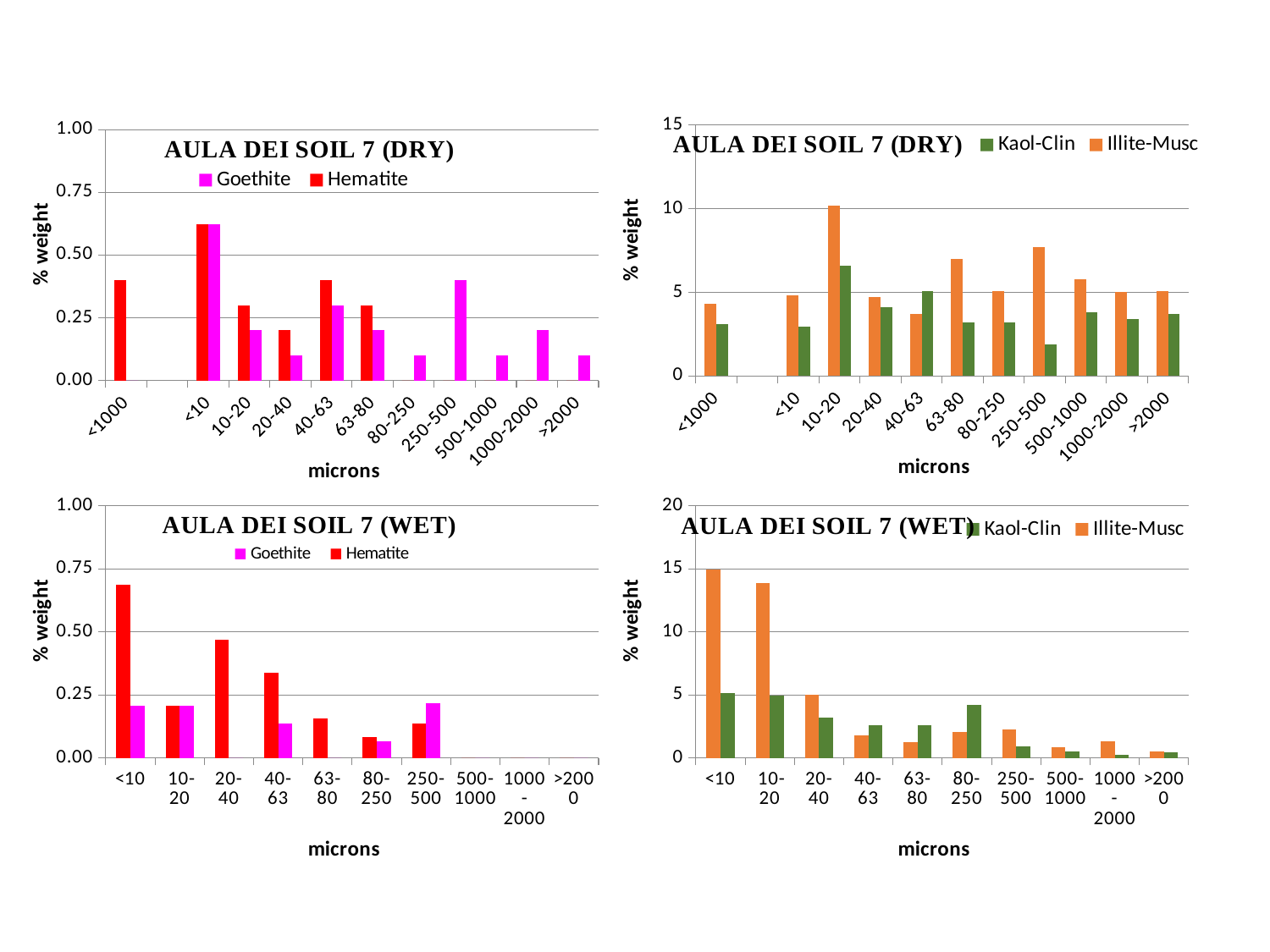
In the bottom-left chart (AULA DEI SOIL 7 (WET), Goethite/Hematite), is the Hematite value for 20-40 greater or less than 0.25? greater In the bottom-right chart (AULA DEI SOIL 7 (WET), Kaol-Clin/Illite-Musc), which is larger for the <10 category, Kaol-Clin or Illite-Musc? Illite-Musc In the top-left chart (AULA DEI SOIL 7 (DRY), Goethite/Hematite), is the Hematite value for <1000 greater or less than 0.25? greater In the top-left chart (AULA DEI SOIL 7 (DRY), Goethite/Hematite), how many micron categories are shown on the x axis? 11 In the top-right chart (AULA DEI SOIL 7 (DRY), Kaol-Clin/Illite-Musc), is the Illite-Musc value for 250-500 greater or less than 5? greater In the top-right chart (AULA DEI SOIL 7 (DRY), Kaol-Clin/Illite-Musc), which micron category has the highest Illite-Musc value? 10-20 In the top-left chart (AULA DEI SOIL 7 (DRY), Goethite/Hematite), how many series does the legend list? 2 In the top-left chart (AULA DEI SOIL 7 (DRY), Goethite/Hematite), which micron category has the highest Hematite value? <10 In the top-right chart (AULA DEI SOIL 7 (DRY), Kaol-Clin/Illite-Musc), which micron category has the lowest Kaol-Clin value? 250-500 In the bottom-left chart (AULA DEI SOIL 7 (WET), Goethite/Hematite), which micron category has the highest Hematite value? <10 What type of chart is the bottom-right chart (AULA DEI SOIL 7 (WET), Kaol-Clin/Illite-Musc)? Bar chart